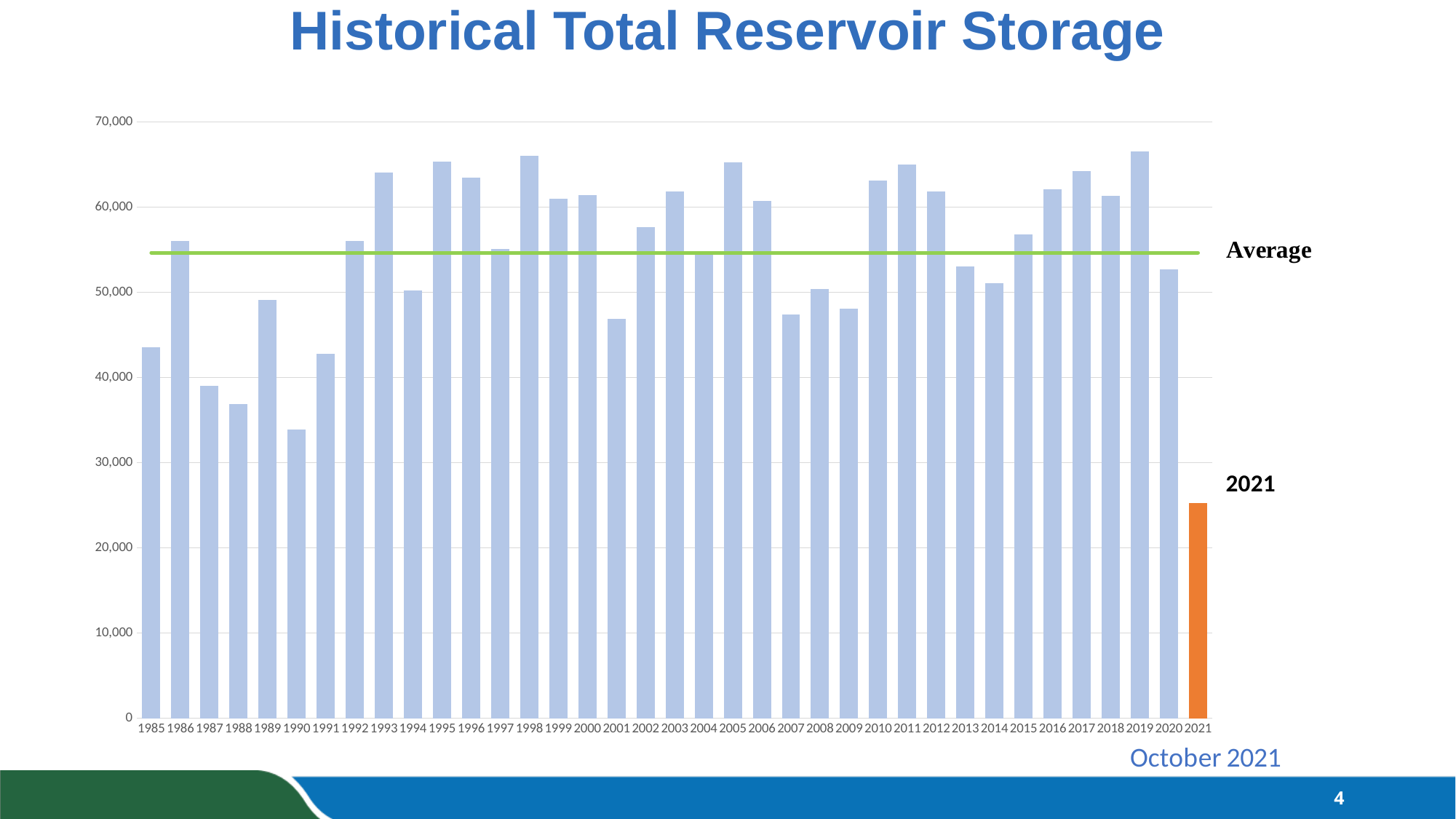
Which year has the lowest total reservoir storage? 2021 How many years (bars) are plotted on the chart? 37 Is the value for 2007 greater or less than 50,000? less Is the value for 1998 greater or less than 60,000? greater What does the green horizontal line across the chart represent? Average What kind of chart is shown on the slide? Bar chart What is the title of the chart? Historical Total Reservoir Storage Is the value for 2021 greater or less than 30,000? less Which year has the larger value, 2020 or 2021? 2020 Do the values rise or fall from 1986 to 1988? fall Which year has the larger value, 1993 or 1994? 1993